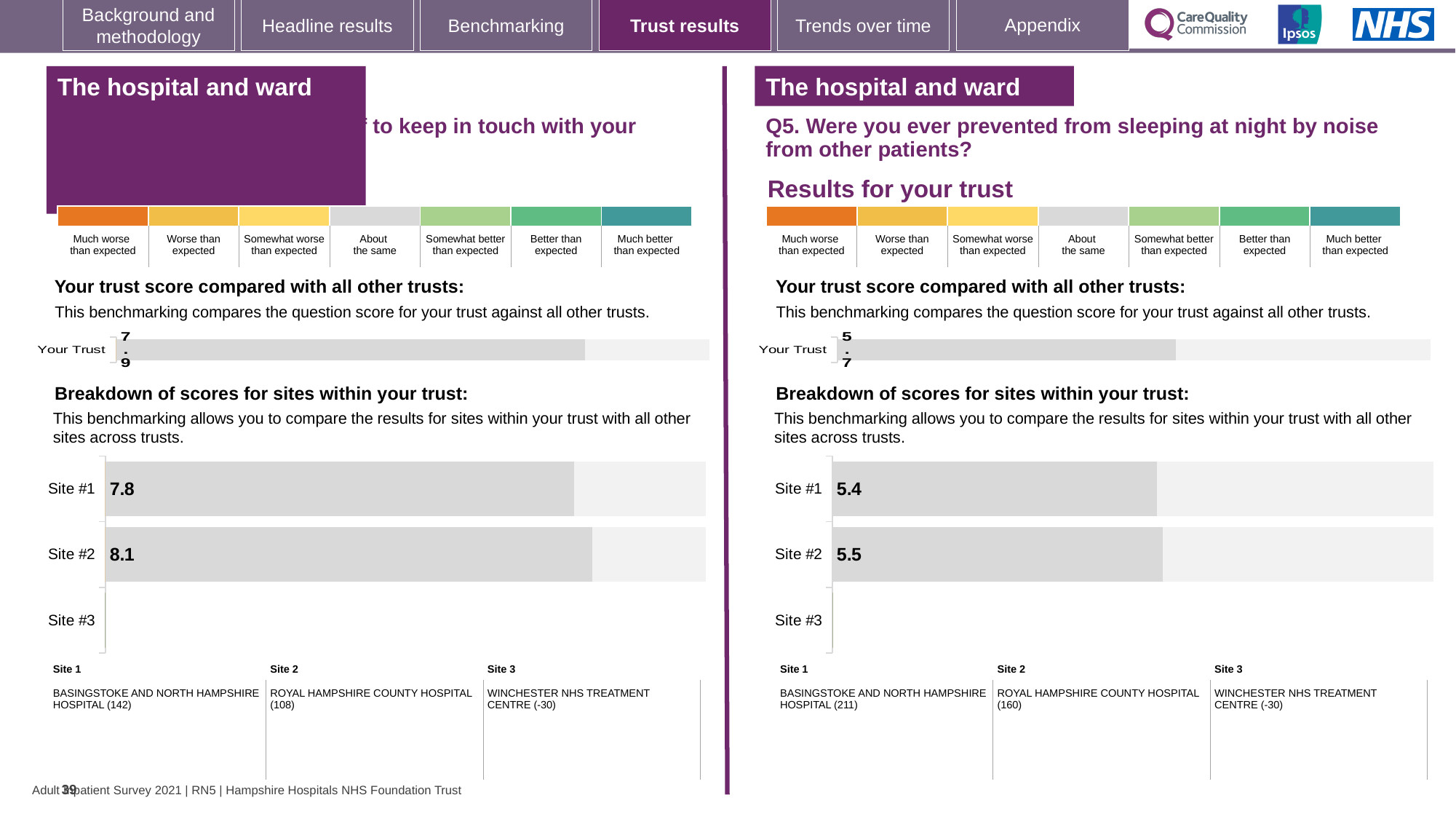
In the right-hand site breakdown chart (Q5), what is the difference between the Site #2 score and the Site #1 score? 0.1 In the left-hand 'Breakdown of scores for sites within your trust' chart, what is the score for Site #1? 7.8 In the right-hand 'Breakdown of scores for sites within your trust' chart (Q5), what is the score for Site #2? 5.5 In the left-hand site breakdown chart, what is the difference between the Site #2 score and the Site #1 score? 0.3 On the left-hand slide half, what is the 'Your Trust' score shown in the trust comparison bar chart? 7.9 In the left-hand site breakdown chart, which site has the higher score, Site #1 or Site #2? Site #2 On the right-hand slide half (Q5, prevented from sleeping by noise), what is the 'Your Trust' score shown in the trust comparison bar chart? 5.7 How many site categories are listed on the axis of the right-hand site breakdown chart (Q5)? 3 In the left-hand 'Breakdown of scores for sites within your trust' chart, what is the score for Site #2? 8.1 In the right-hand 'Breakdown of scores for sites within your trust' chart (Q5), what is the score for Site #1? 5.4 In the right-hand site breakdown chart (Q5), which site has no bar or score shown? Site #3 What type of chart is used for the 'Breakdown of scores for sites within your trust' on the right-hand half (Q5)? Bar chart